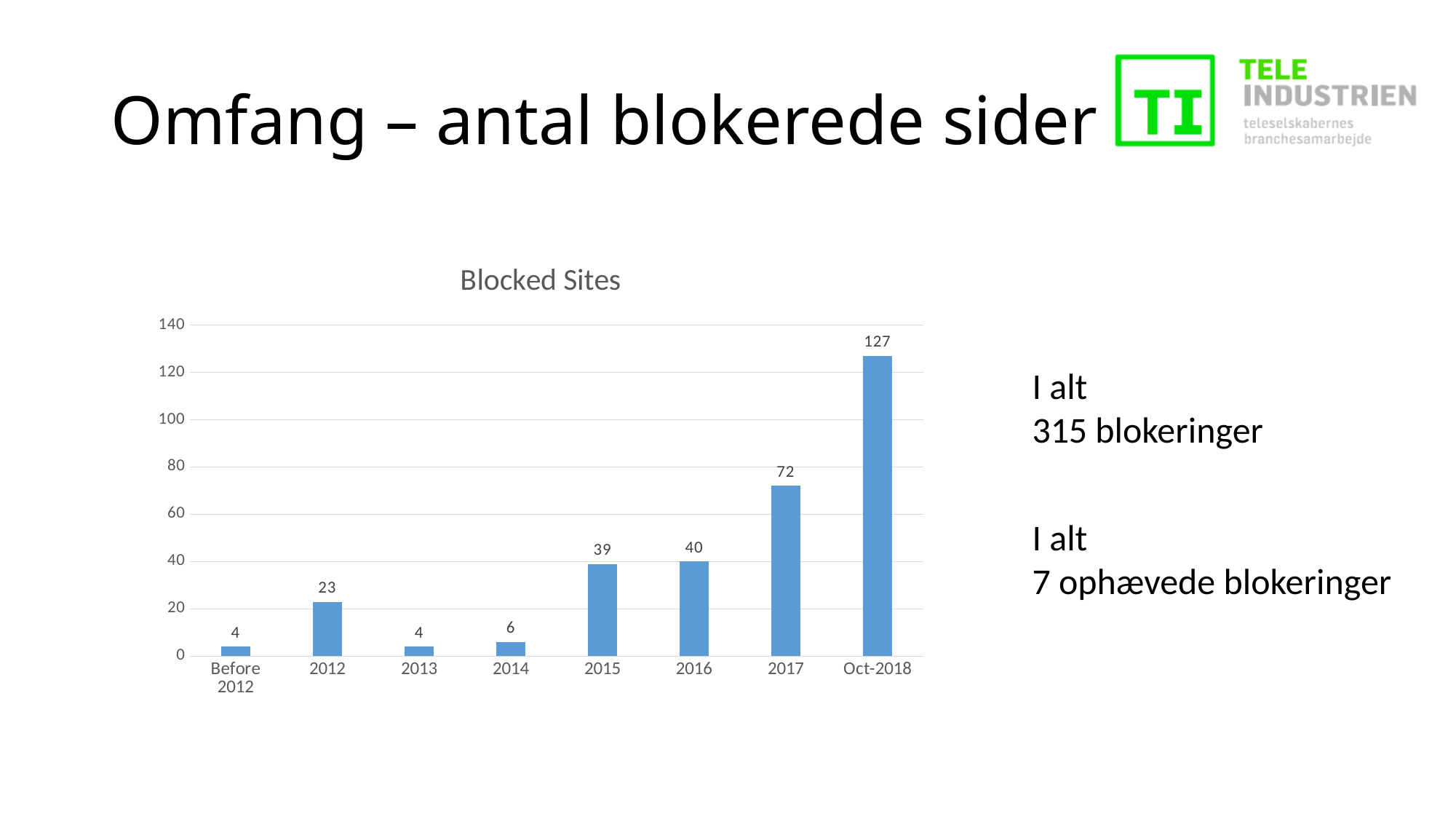
What is the difference between the values for 2015 and 2014 in the Blocked Sites chart? 33 Do the values in the Blocked Sites chart generally rise or fall from 2013 to Oct-2018? rise What kind of chart is the Blocked Sites chart? bar chart What is the title of the chart on the slide? Blocked Sites What is the difference between the values for Oct-2018 and 2017 in the Blocked Sites chart? 55 What is the value for 2012 in the Blocked Sites chart? 23 Is the value for 2017 in the Blocked Sites chart greater or less than 60? greater What is the value for 2017 in the Blocked Sites chart? 72 Which is larger in the Blocked Sites chart, the value for 2012 or the value for 2014? 2012 What is the value for Oct-2018 in the Blocked Sites chart? 127 Which category has the highest value in the Blocked Sites chart? Oct-2018 How many categories are shown on the x axis of the Blocked Sites chart? 8